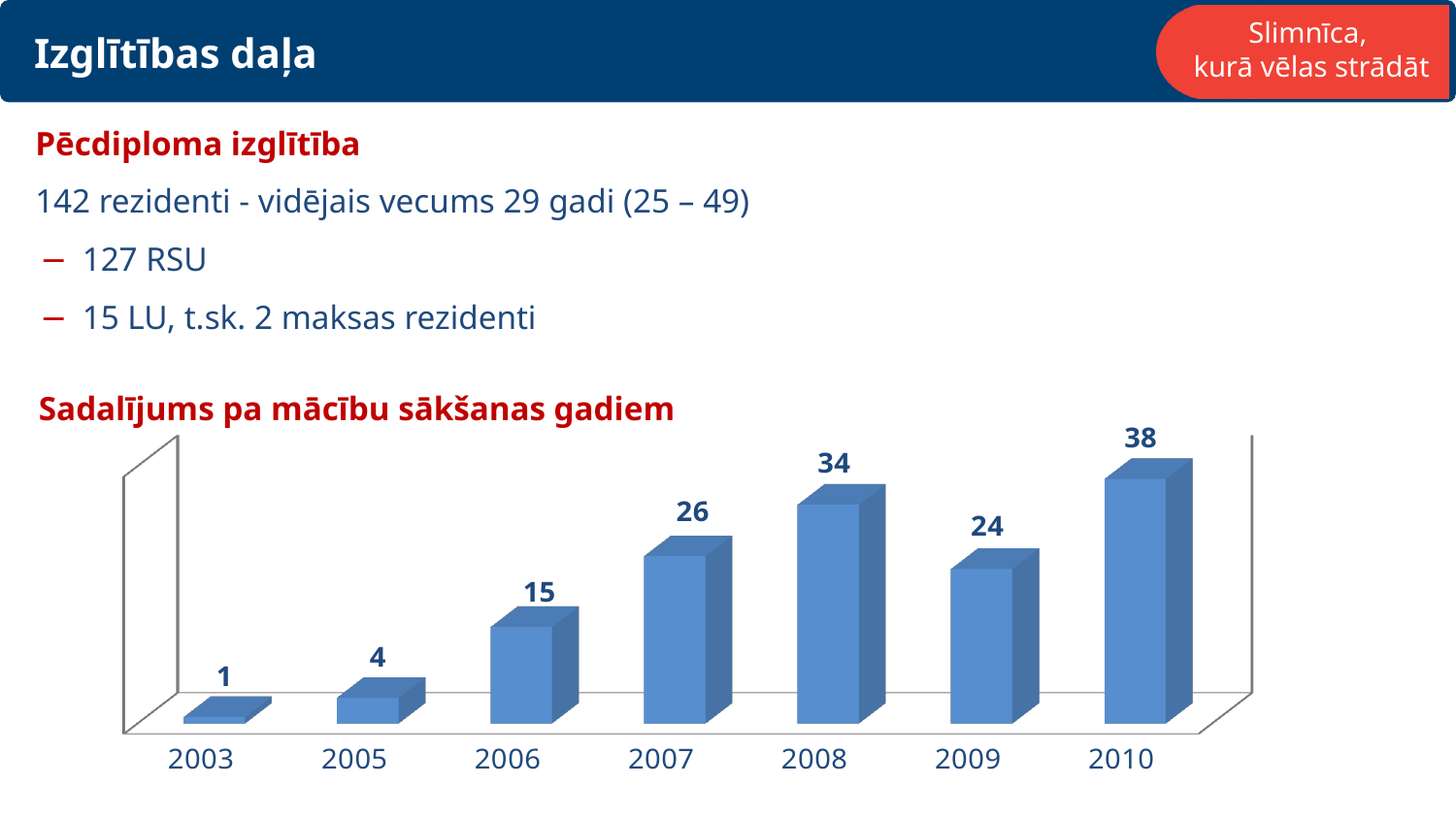
What is the difference between the values for 2007 and 2006? 11 Which year has the lowest value in the chart? 2003 What kind of chart is shown on the slide? bar chart How many years are shown on the x axis of the chart? 7 What is the value for 2009 in the chart? 24 What is the value for 2008 in the chart? 34 Which is larger, the value for 2008 or the value for 2009? 2008 Do the values rise or fall from 2003 to 2008? rise What is the difference between the values for 2010 and 2009? 14 What is the value for 2005 in the chart? 4 Which year has the highest value in the chart? 2010 What is the title of the chart? Sadalījums pa mācību sākšanas gadiem